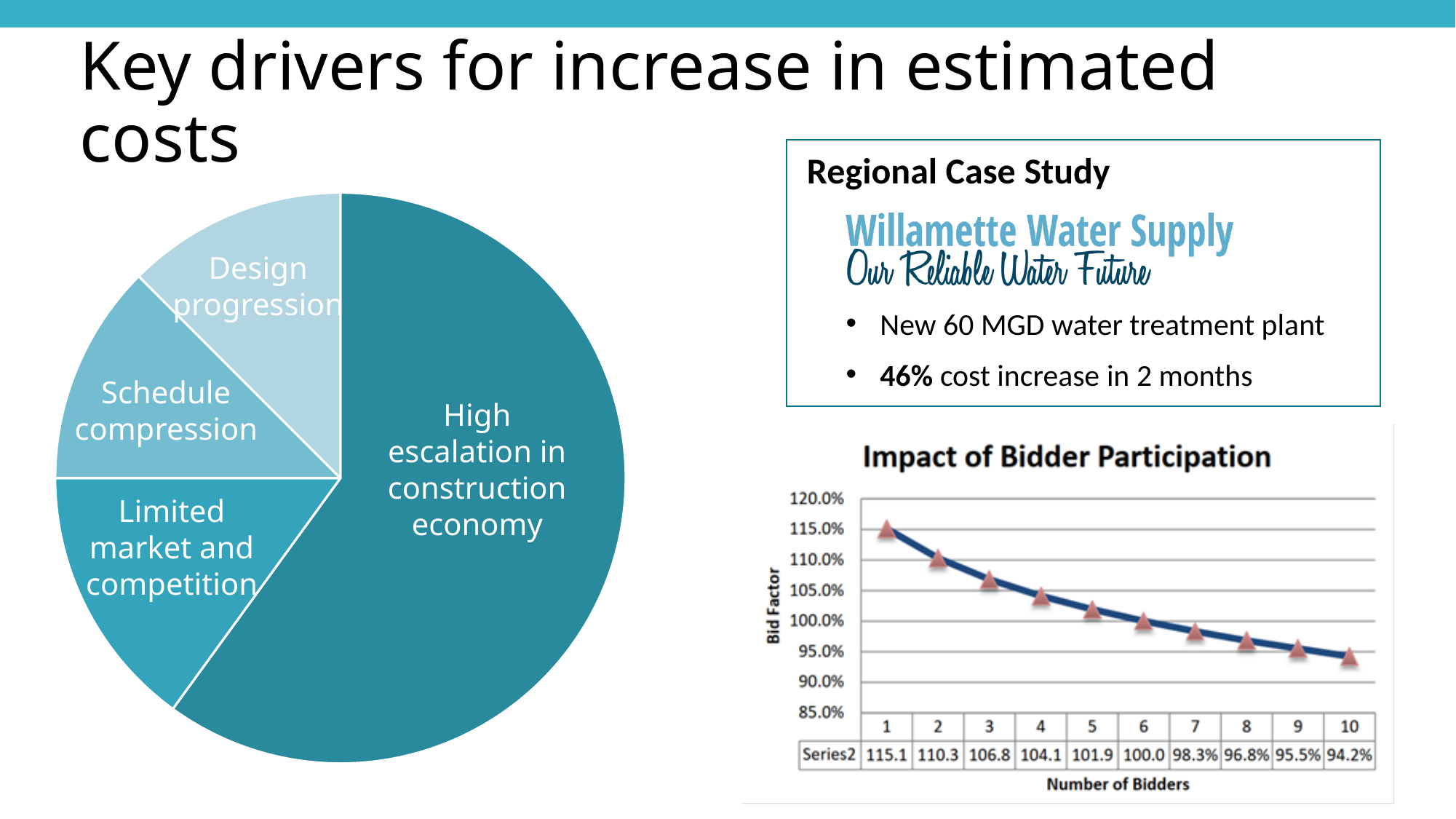
In the chart titled "Impact of Bidder Participation", what is the bid factor for 6 bidders? 100.0 What kind of chart is the "Impact of Bidder Participation" chart? line chart In the chart titled "Impact of Bidder Participation", what is the bid factor when the number of bidders is 1? 115.1 In the chart titled "Impact of Bidder Participation", what is the difference between the bid factor for 1 bidder and the bid factor for 10 bidders? 20.9 In the pie chart on the left of the slide, which slice is the largest? High escalation in construction economy In the chart titled "Impact of Bidder Participation", what is the label of the vertical axis? Bid Factor In the chart titled "Impact of Bidder Participation", does the bid factor rise or fall as the number of bidders increases? fall In the chart titled "Impact of Bidder Participation", what is the bid factor when the number of bidders is 10? 94.2% In the chart titled "Impact of Bidder Participation", which number of bidders has the lowest bid factor? 10 In the chart titled "Impact of Bidder Participation", which number of bidders has the highest bid factor? 1 How many slices does the pie chart on the left of the slide have? 4 In the chart titled "Impact of Bidder Participation", how many data points are plotted? 10